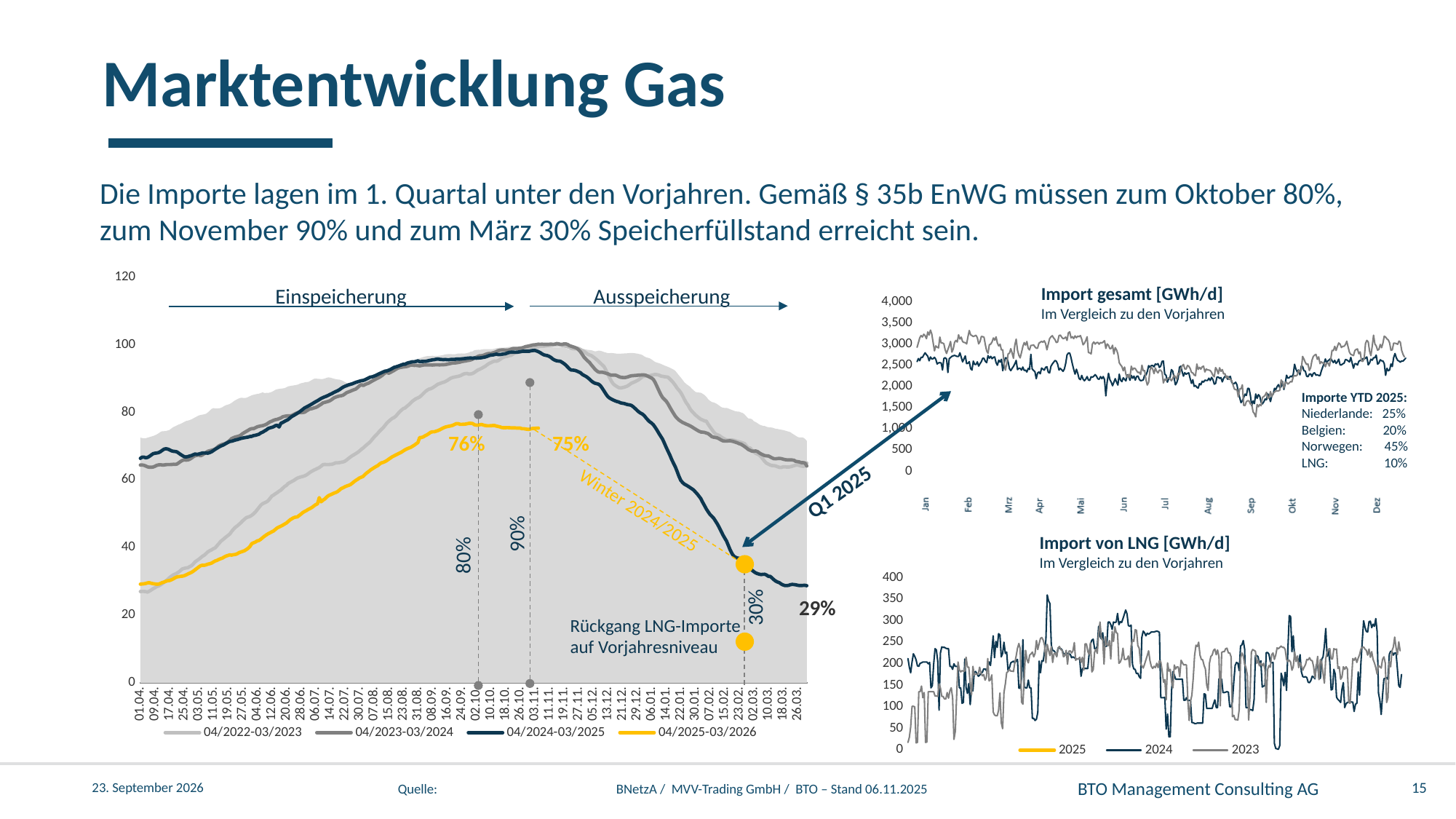
In the large chart on the left, what value is labelled at the end of the 04/2024-03/2025 series (26.03.)? 29% In the large chart on the left, what value is labelled on the 04/2025-03/2026 series at the 03.11. marker? 75% In the large chart on the left, what value is labelled on the 04/2025-03/2026 series at the 02.10. marker? 76% In the large chart on the left, which series is drawn in yellow? 04/2025-03/2026 How many series does the legend of the 'Import von LNG [GWh/d]' chart list? 3 In the large chart on the left, is the peak value of the 04/2024-03/2025 series greater or less than 80? greater In the large chart on the left, at 01.04., which series has the higher value: 04/2024-03/2025 or 04/2025-03/2026? 04/2024-03/2025 What kind of chart is the large chart on the left of the slide? line chart In the large chart on the left, does the 04/2025-03/2026 series rise or fall between 01.04. and 02.10.? rise How many series does the legend of the large chart on the left list? 4 In the large chart on the left, is the peak value of the 04/2025-03/2026 series greater or less than 80? less In the large chart on the left, does the 04/2024-03/2025 series rise or fall between 03.11. and 26.03.? fall